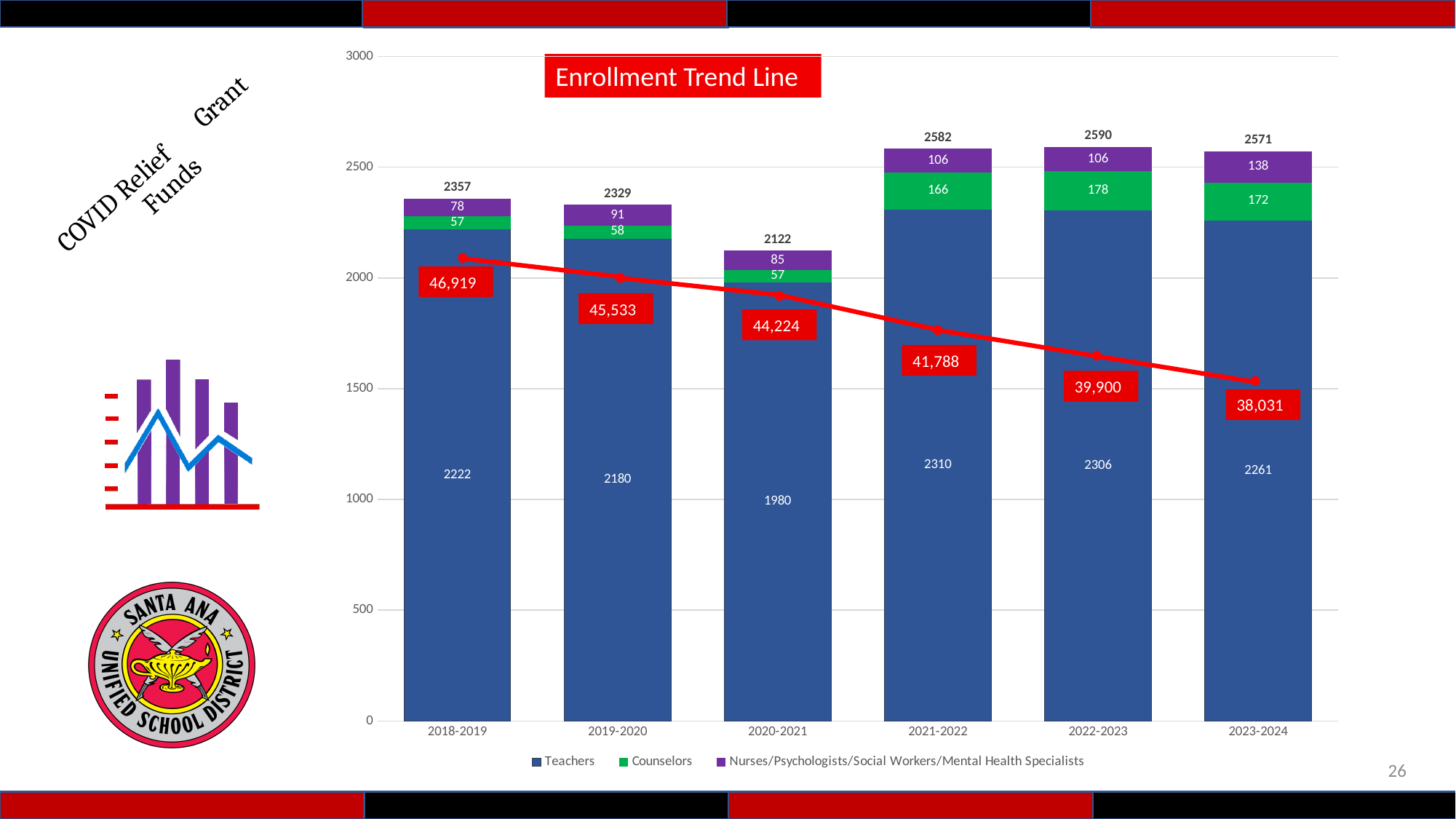
What is the title shown in the red box at the top of the chart? Enrollment Trend Line Which year has the highest stacked bar total? 2022-2023 How many years are shown on the x axis? 6 What is the number of Teachers in 2020-2021? 1980 Which is larger, the Nurses/Psychologists/Social Workers/Mental Health Specialists value in 2023-2024 or in 2021-2022? 2023-2024 What is the difference in enrollment between 2018-2019 and 2019-2020? 1,386 Does the enrollment trend line rise or fall from 2018-2019 to 2023-2024? fall What is the number of Counselors in 2022-2023? 178 How many series does the legend list? 3 Which year has the lowest number of Teachers? 2020-2021 What is the total of the stacked bar for 2021-2022? 2582 What is the enrollment value shown on the trend line for 2023-2024? 38,031